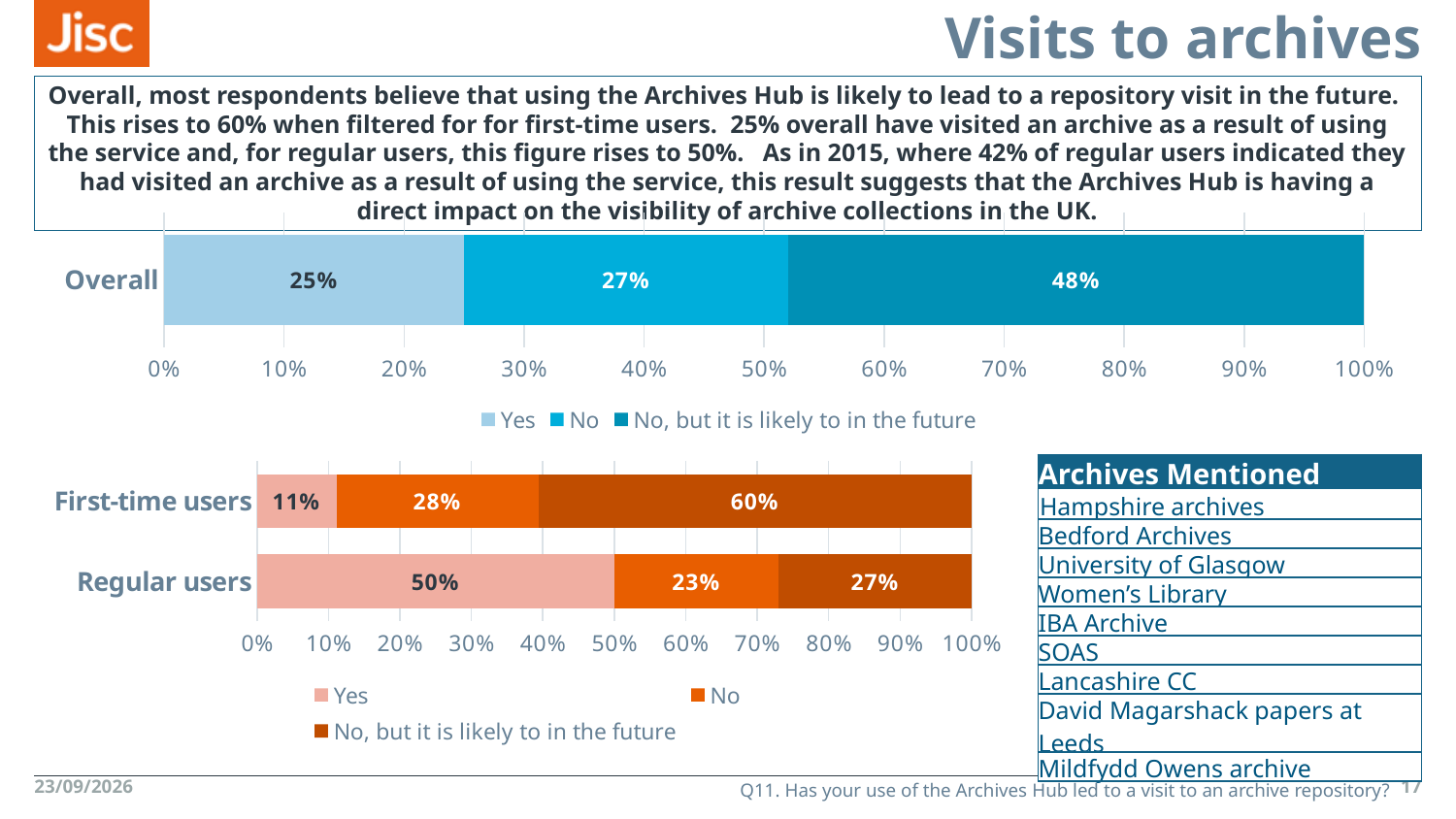
In the top chart, which response has the largest share for Overall? No, but it is likely to in the future In the bottom chart, what percentage of Regular users answered Yes? 50% In the bottom chart, what percentage of First-time users answered 'No, but it is likely to in the future'? 60% In the top chart, what percentage of Overall respondents answered Yes? 25% In the bottom chart, what percentage of Regular users answered No? 23% How many series does the legend of the bottom chart list? 3 In the bottom chart, which category has the higher Yes value, First-time users or Regular users? Regular users In the bottom chart, what is the difference between the Yes values for Regular users and First-time users? 39% How many categories are shown in the bottom chart? 2 In the top chart, what percentage of Overall respondents answered 'No, but it is likely to in the future'? 48% In the bottom chart, which response has the smallest share for First-time users? Yes What type of chart is the top chart? Stacked bar chart